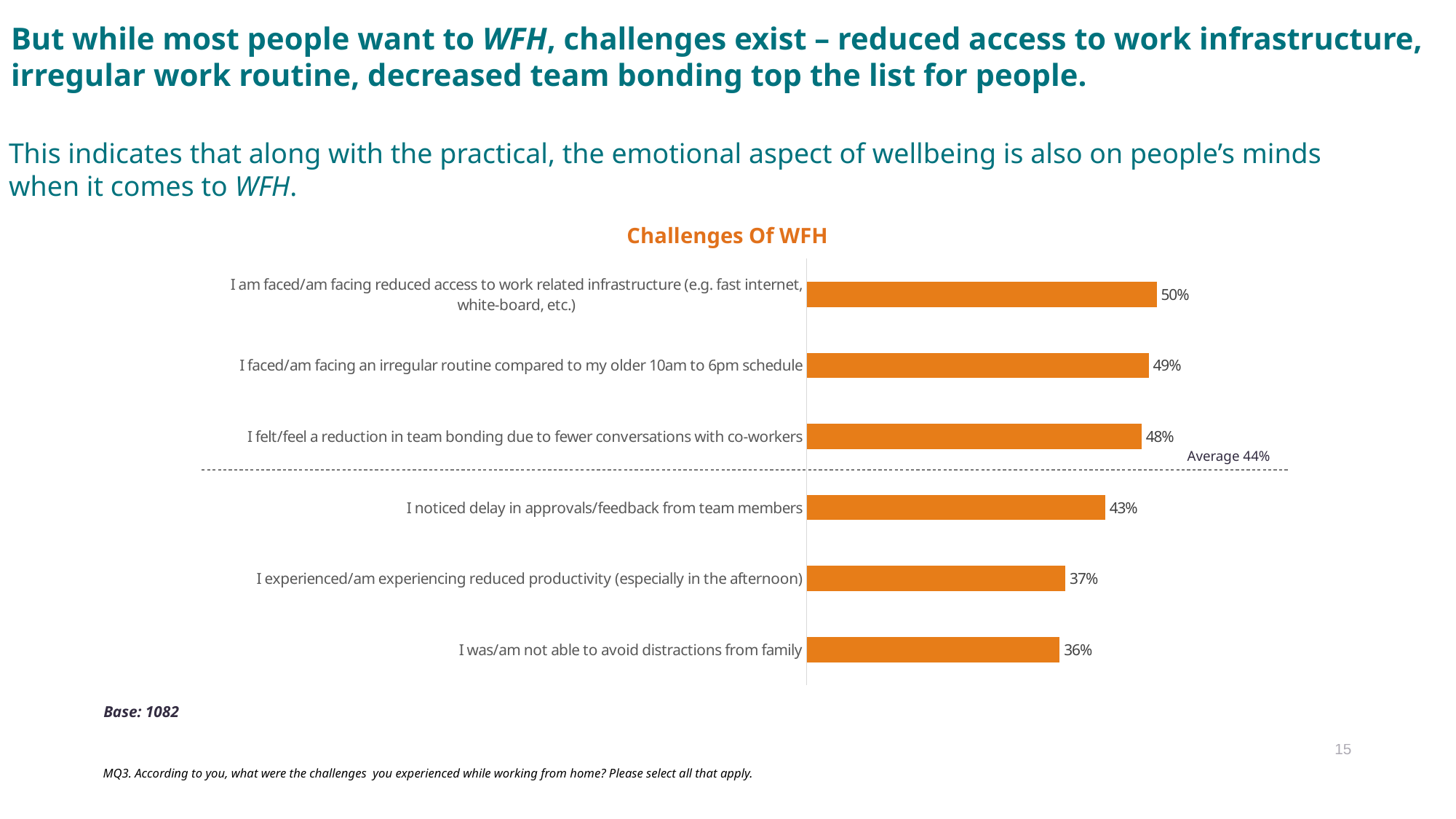
How many challenges are plotted in the chart? 6 Which challenge has the lowest value? I was/am not able to avoid distractions from family Which challenge has the highest value? I am faced/am facing reduced access to work related infrastructure (e.g. fast internet, white-board, etc.) What is the difference between the value for reduced access to work related infrastructure and the value for not being able to avoid distractions from family? 14% What is the title of the chart? Challenges Of WFH What percentage of respondents said 'I was/am not able to avoid distractions from family'? 36% What is the difference between the value for reduction in team bonding and the value for reduced productivity? 11% Which is larger: the value for 'I faced/am facing an irregular routine compared to my older 10am to 6pm schedule' or the value for 'I experienced/am experiencing reduced productivity (especially in the afternoon)'? I faced/am facing an irregular routine compared to my older 10am to 6pm schedule What is the value for 'I am faced/am facing reduced access to work related infrastructure (e.g. fast internet, white-board, etc.)'? 50% What average value is marked by the dashed line on the chart? 44% What is the value for 'I noticed delay in approvals/feedback from team members'? 43% What kind of chart is shown on the slide? Bar chart